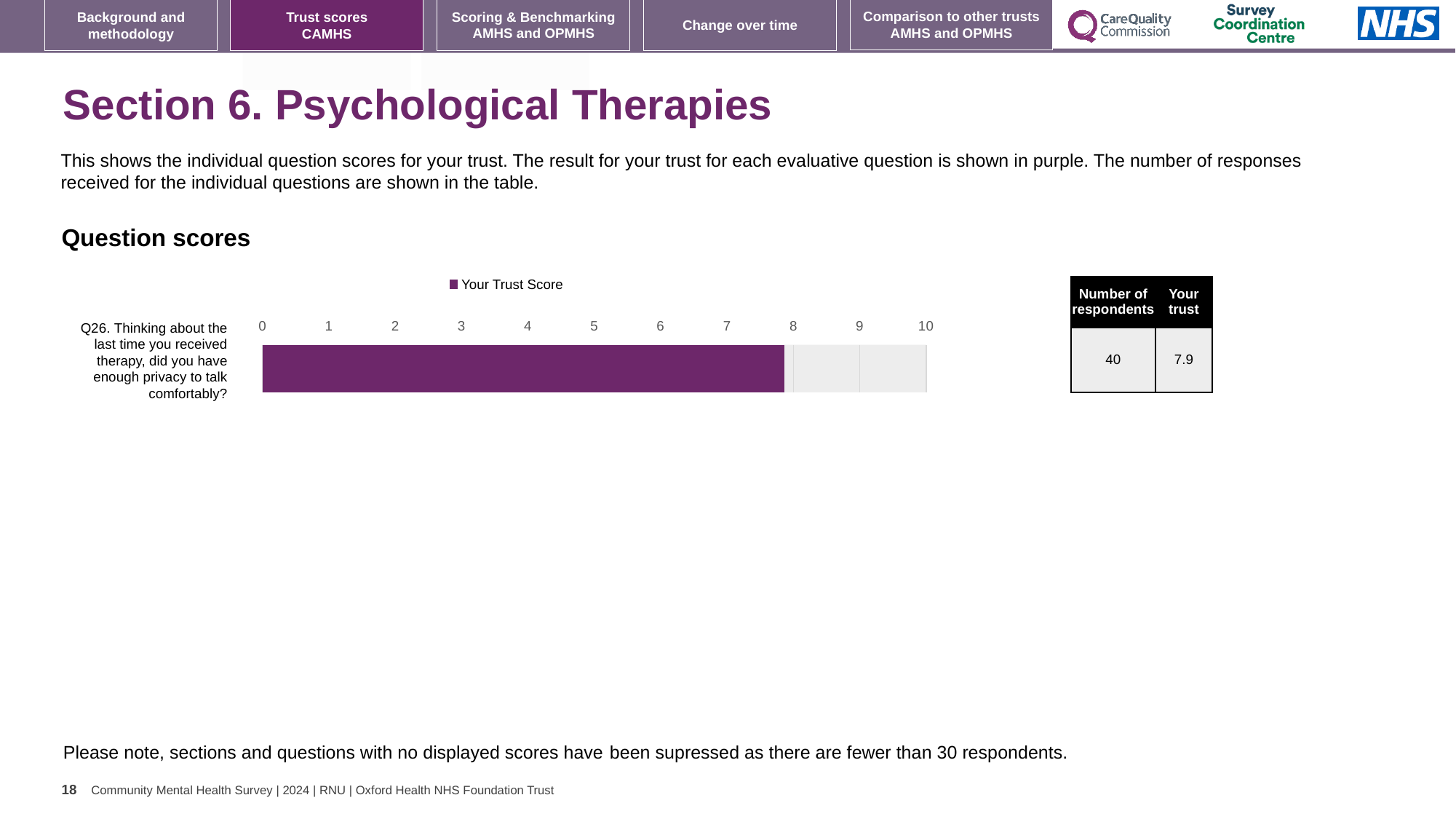
Is the trust score for Q26 greater or less than 5? greater How many respondents answered Q26 according to the table beside the chart? 40 Is the trust score for Q26 greater or less than 8? less Which question is plotted in the chart? Q26. Thinking about the last time you received therapy, did you have enough privacy to talk comfortably? What is the trust score for Q26 (privacy to talk comfortably during therapy)? 7.9 What kind of chart is shown under 'Question scores'? bar chart What series name appears in the chart legend? Your Trust Score How many questions (categories) are plotted in the chart? 1 How many series does the chart legend list? 1 What is the maximum value shown on the chart's horizontal axis? 10